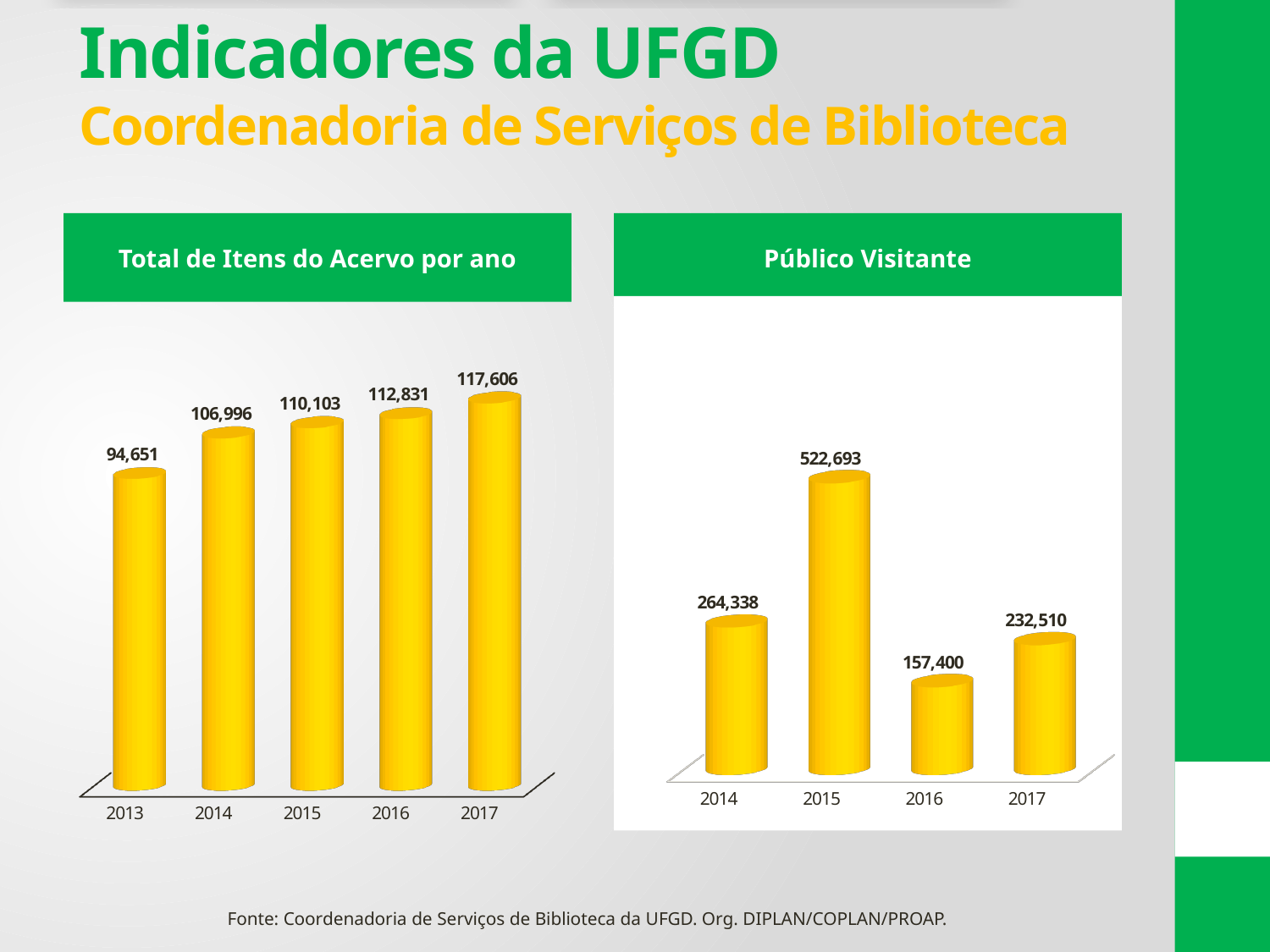
In the 'Público Visitante' chart, which is larger, the value for 2014 or the value for 2017? 2014 In the 'Público Visitante' chart, which year has the lowest value? 2016 In the 'Total de Itens do Acervo por ano' chart, what is the difference between the 2017 and 2013 values? 22,955 In the 'Total de Itens do Acervo por ano' chart, do the values rise or fall from 2013 to 2017? rise In the 'Total de Itens do Acervo por ano' chart, which year has the highest value? 2017 What type of chart is the 'Público Visitante' chart? bar chart In the 'Público Visitante' chart, what is the difference between the 2015 and 2016 values? 365,293 In the 'Total de Itens do Acervo por ano' chart, how many years are shown? 5 In the 'Total de Itens do Acervo por ano' chart, what is the value for 2013? 94,651 In the 'Público Visitante' chart, what is the value for 2015? 522,693 In the 'Total de Itens do Acervo por ano' chart, what is the value for 2016? 112,831 In the 'Público Visitante' chart, how many years are shown? 4